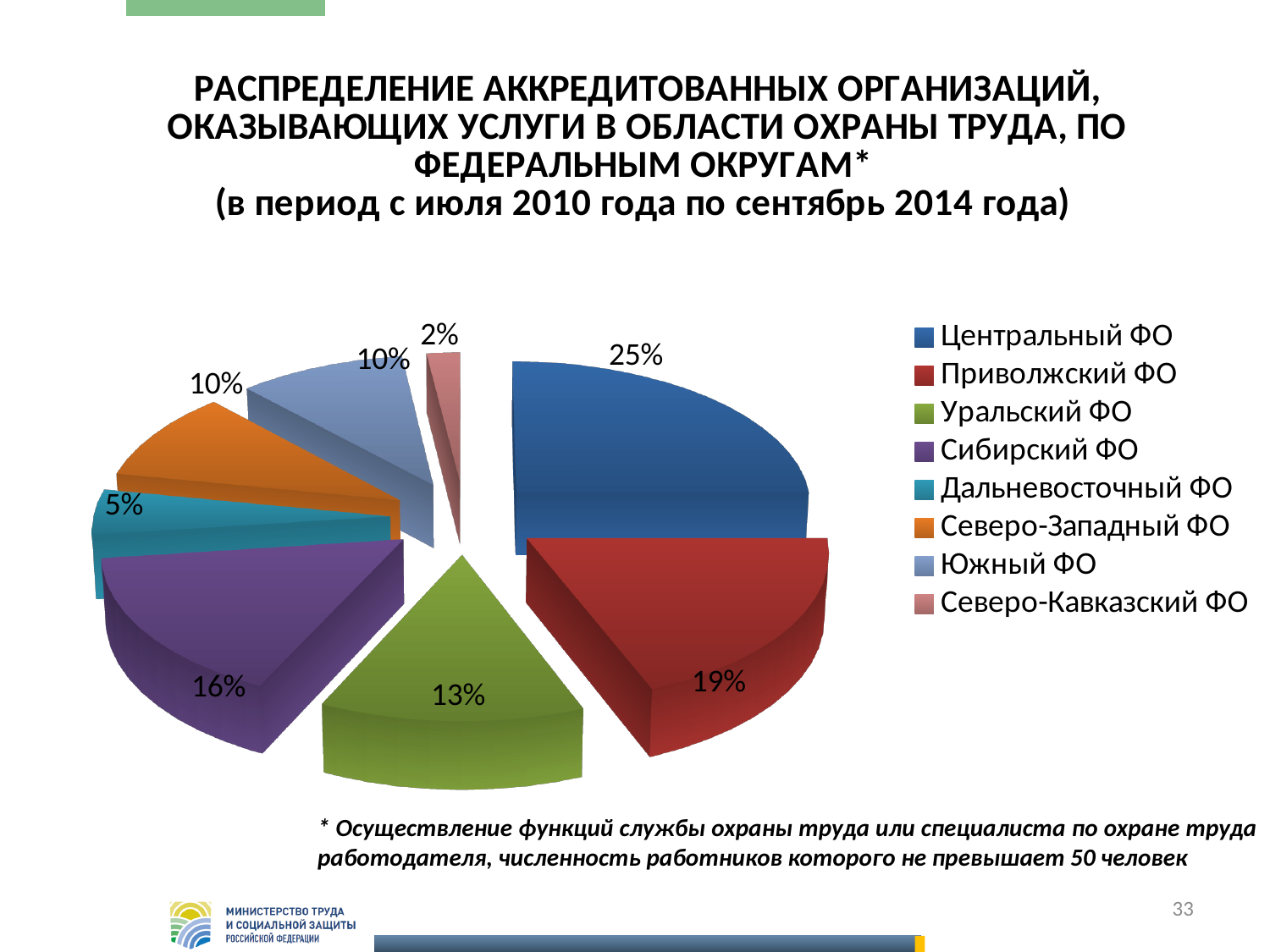
How many categories does the legend list? 8 What share of the pie does Центральный ФО have? 25% Which federal district has the largest slice of the pie? Центральный ФО What share of the pie does Сибирский ФО have? 16% What share of the pie does Приволжский ФО have? 19% What is the difference in percentage points between Центральный ФО and Приволжский ФО? 6 Which is larger, the share of Сибирский ФО or the share of Уральский ФО? Сибирский ФО Which federal district has the smallest slice of the pie? Северо-Кавказский ФО What kind of chart is shown on the slide? pie chart What colour is the slice for Северо-Западный ФО? orange